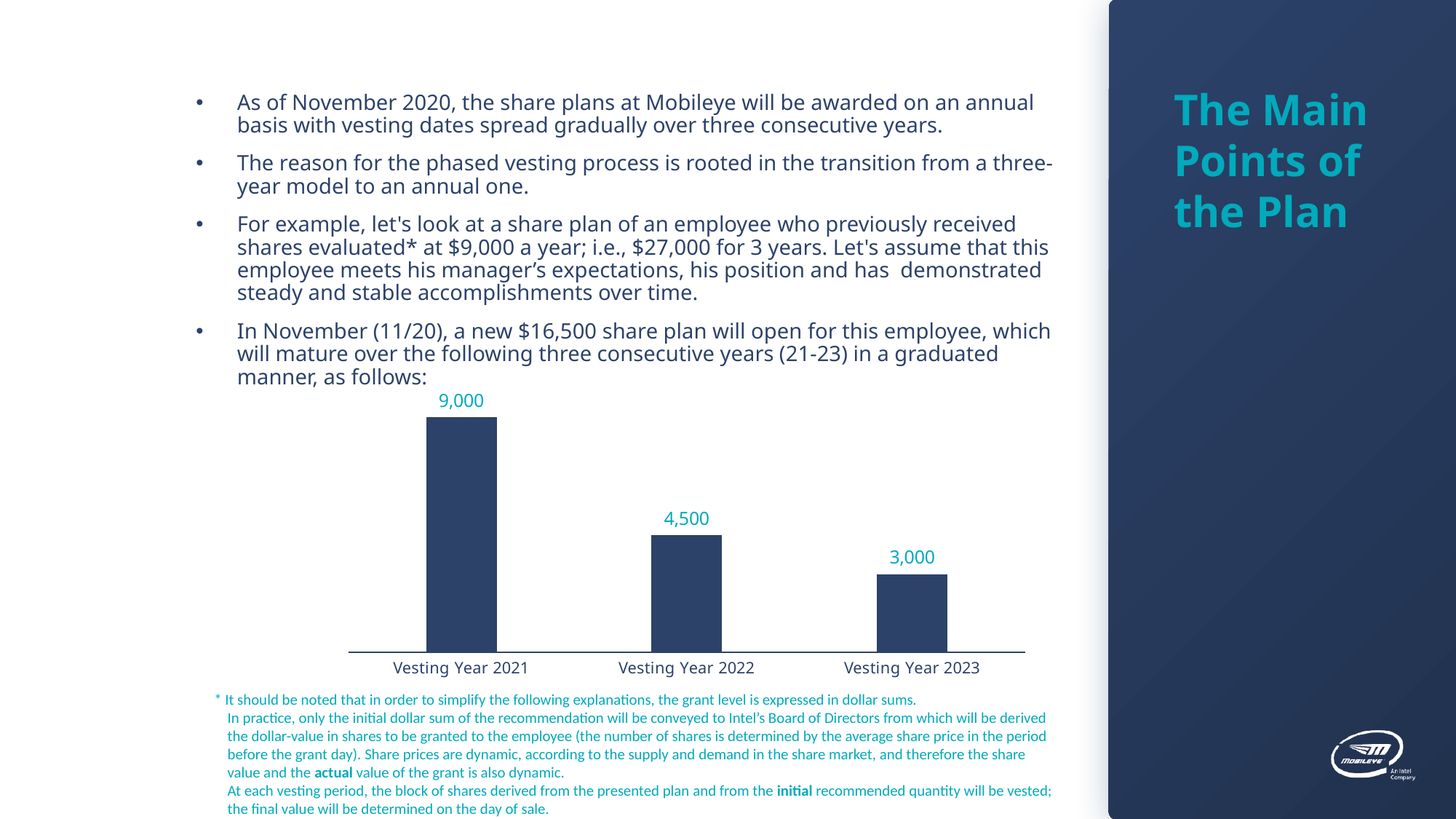
Which vesting year has the highest value? Vesting Year 2021 How many vesting years are shown in the chart? 3 What is the difference between the values for Vesting Year 2021 and Vesting Year 2022? 4,500 What is the value for Vesting Year 2022? 4,500 What is the value for Vesting Year 2021? 9,000 What is the value for Vesting Year 2023? 3,000 What is the total of the three vesting year values shown in the chart? 16,500 What kind of chart is shown on the slide? Bar chart Which is larger, the value for Vesting Year 2022 or Vesting Year 2023? Vesting Year 2022 Do the values rise or fall from Vesting Year 2021 to Vesting Year 2023? Fall Which vesting year has the lowest value? Vesting Year 2023 What is the difference between the values for Vesting Year 2022 and Vesting Year 2023? 1,500